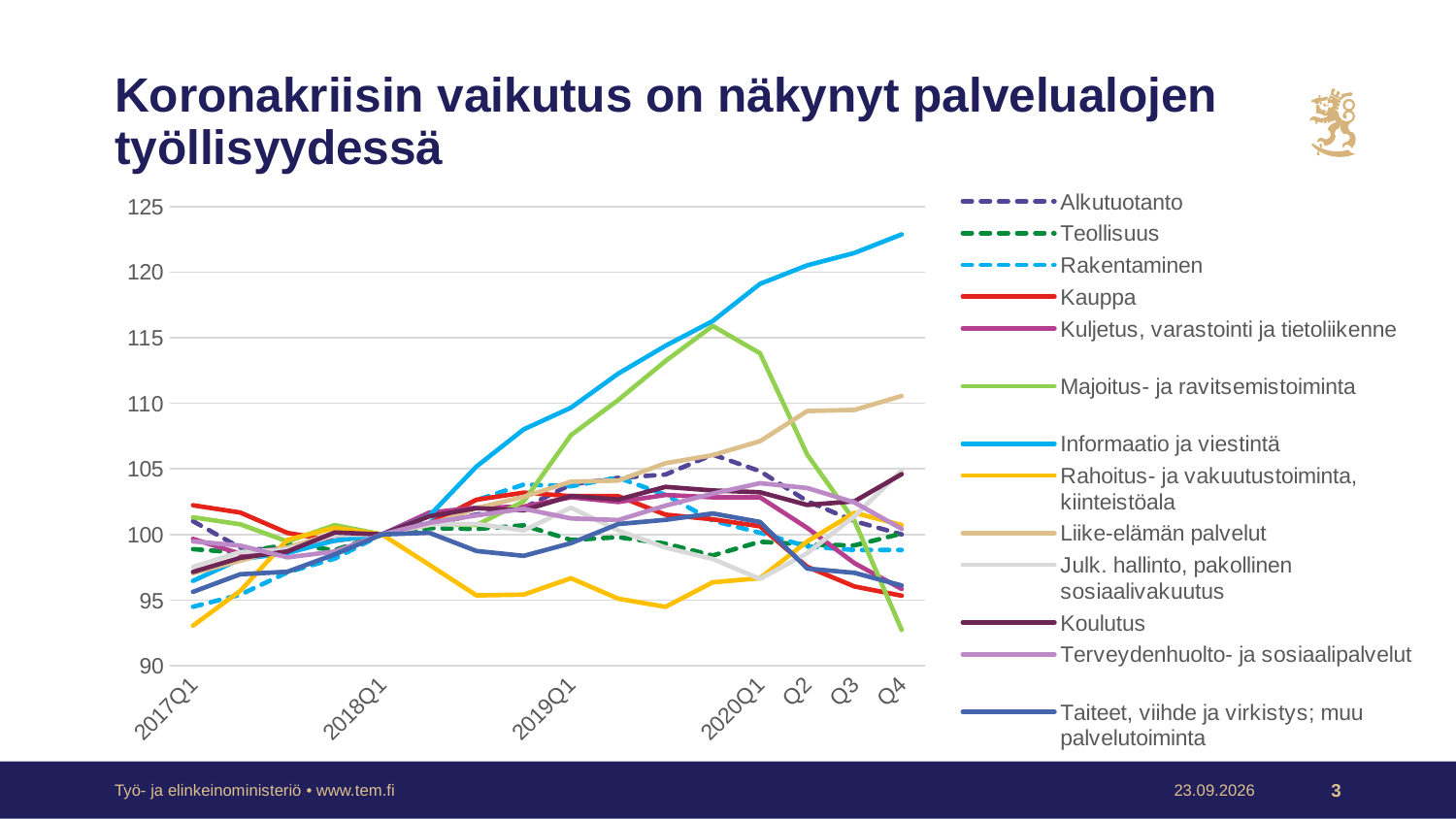
Is the value for Informaatio ja viestintä at 2020 Q4 greater or less than 120? greater How many series does the legend list? 13 Is the value for Liike-elämän palvelut at 2020 Q4 greater or less than 105? greater Which series has the lowest value at 2020 Q4? Majoitus- ja ravitsemistoiminta Does the Informaatio ja viestintä line generally rise or fall from 2017Q1 to 2020 Q4? rise Which series has the highest value at 2020 Q4? Informaatio ja viestintä What kind of chart is shown on the slide? line chart Is the value for Majoitus- ja ravitsemistoiminta at 2020 Q4 greater or less than 95? less What is the title of the slide containing the chart? Koronakriisin vaikutus on näkynyt palvelualojen työllisyydessä At 2020 Q4, which is larger: Informaatio ja viestintä or Kauppa? Informaatio ja viestintä Does the Majoitus- ja ravitsemistoiminta line rise or fall from 2020Q1 to 2020 Q4? fall